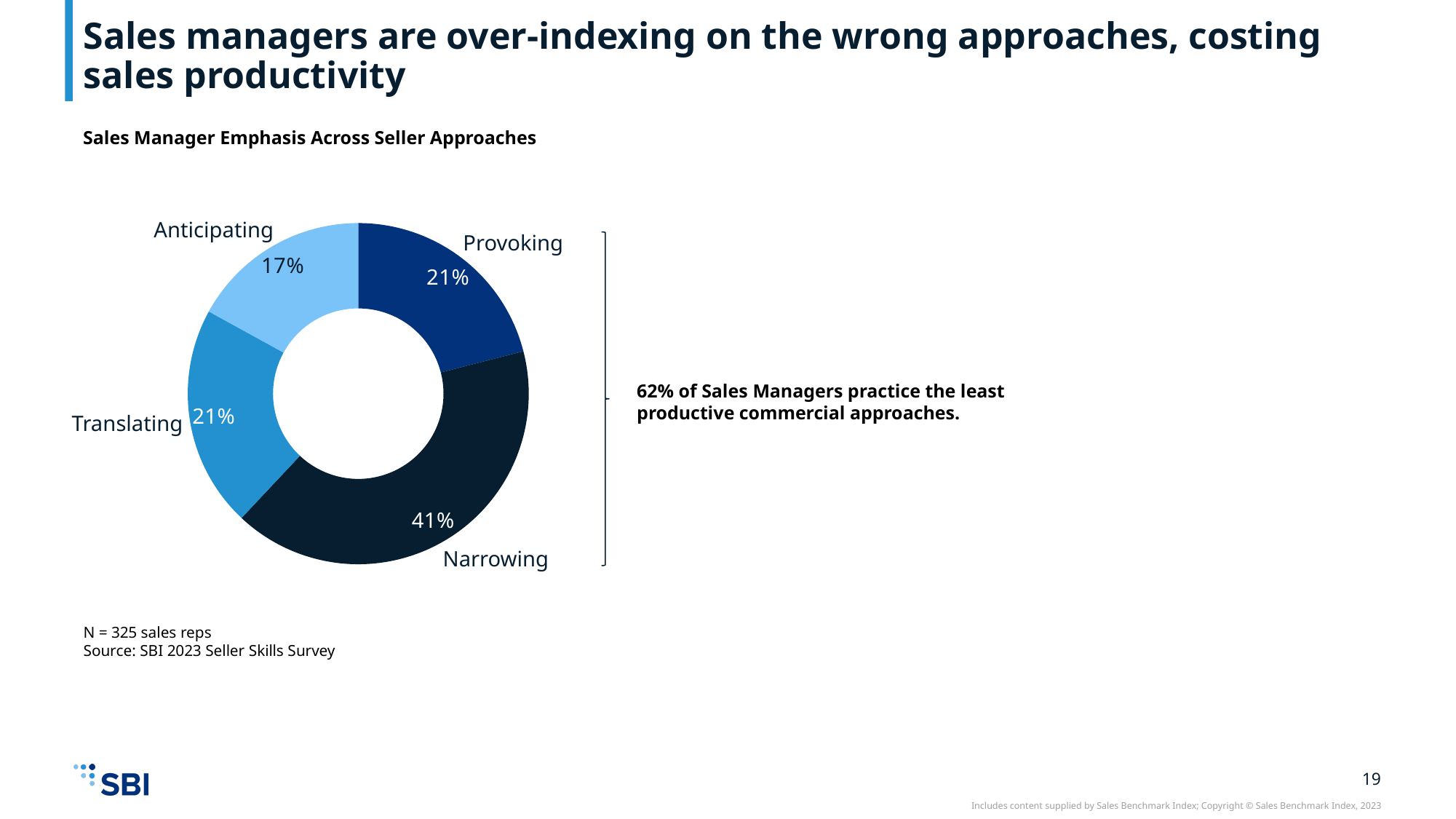
What percentage of the chart is Narrowing? 41% What is the title of the chart? Sales Manager Emphasis Across Seller Approaches Which seller approach has the largest share of the chart? Narrowing How many seller approaches are shown in the chart? 4 Which seller approach has the smallest share of the chart? Anticipating Which is larger, the share for Narrowing or the share for Translating? Narrowing What kind of chart is shown on the slide? Doughnut chart What is the difference in percentage points between Narrowing and Anticipating? 24 What is the difference in percentage points between Provoking and Anticipating? 4 What percentage of the chart is Anticipating? 17% What percentage of the chart is Translating? 21% What percentage of the chart is Provoking? 21%